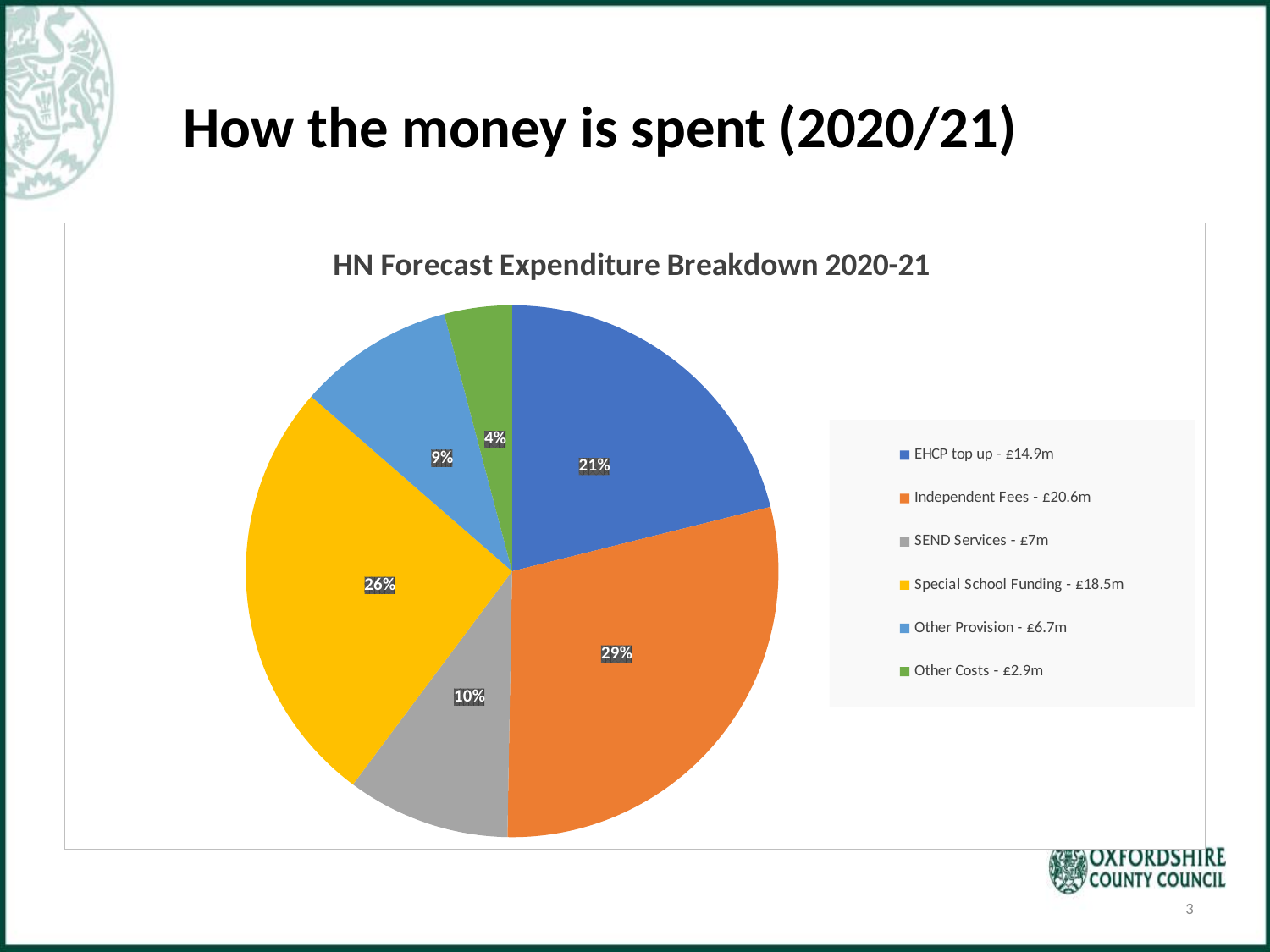
What is the title of the chart? HN Forecast Expenditure Breakdown 2020-21 What is the difference in percentage points between the Independent Fees share and the SEND Services share? 19 How many categories does the legend list? 6 Which has a larger share, Other Provision or SEND Services? SEND Services What type of chart is shown on the slide? Pie chart What percentage share does EHCP top up have in the pie chart? 21% What amount is shown in the legend for Special School Funding? £18.5m What percentage share does Other Costs have in the pie chart? 4% Which category has the smallest share of the pie? Other Costs What percentage share does Independent Fees have in the pie chart? 29% Which category has the largest share of the pie? Independent Fees